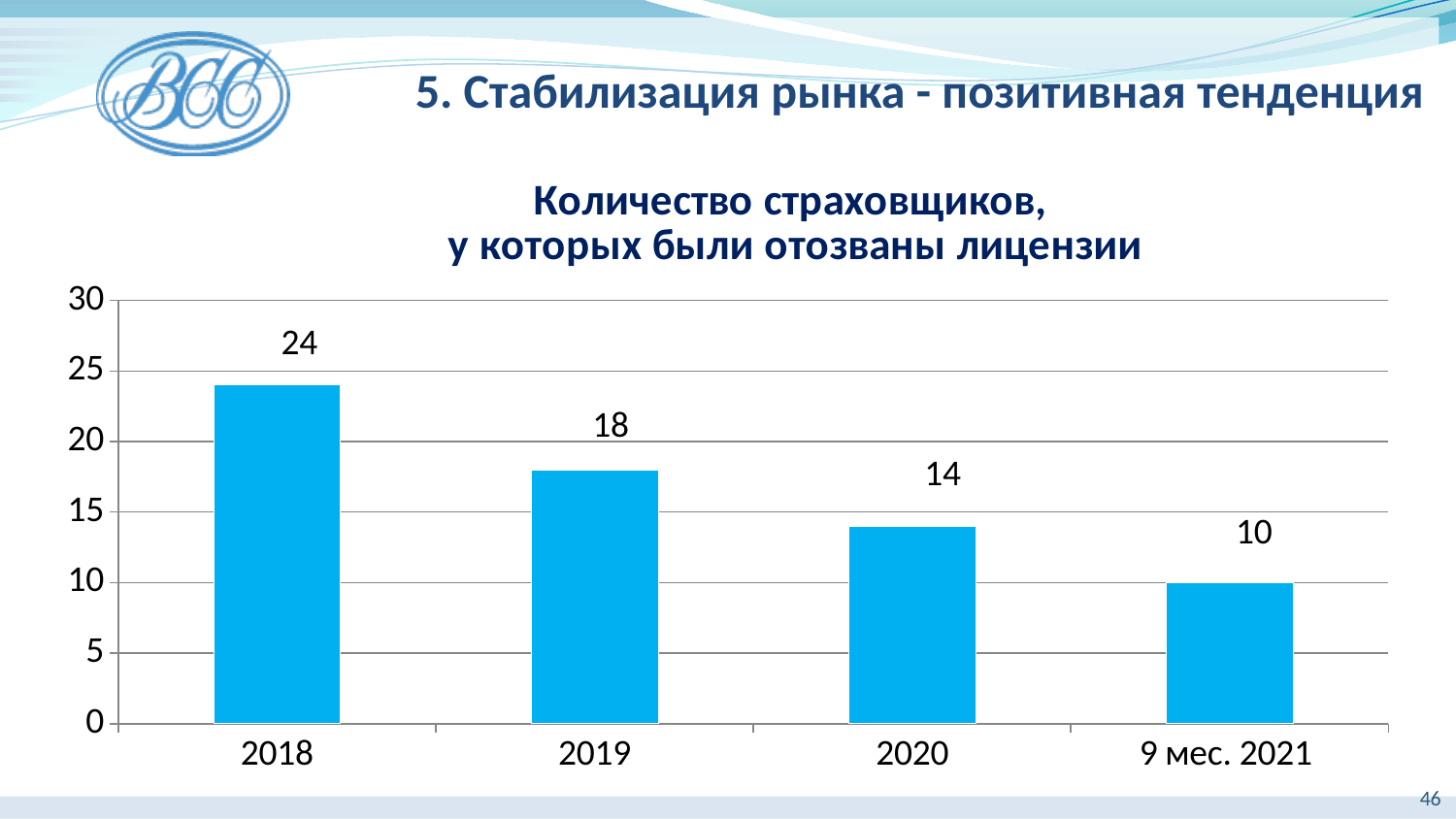
What is the value for 9 мес. 2021? 10 What is the value for 2019? 18 Which category has the lowest value? 9 мес. 2021 What is the value for 2018? 24 What is the difference between the values for 2018 and 2020? 10 Which category has the highest value? 2018 What is the value for 2020? 14 What kind of chart is shown on the slide? bar chart What is the title of the chart? Количество страховщиков, у которых были отозваны лицензии Do the values rise or fall from 2018 to 9 мес. 2021? fall Which is larger, the value for 2019 or the value for 2020? 2019 How many categories are shown on the x axis? 4